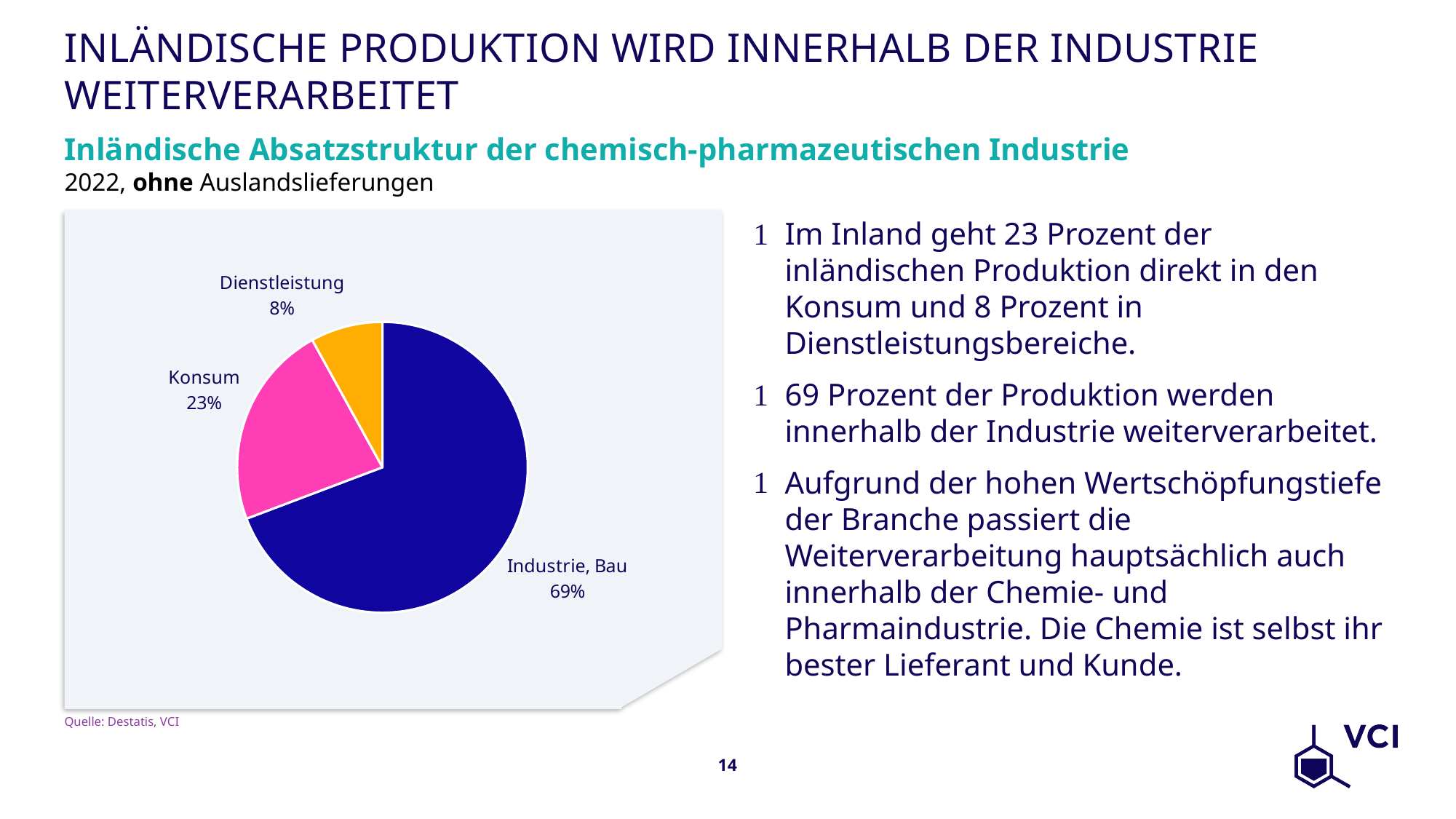
What kind of chart is shown on the slide? pie chart What share of the pie does Dienstleistung have? 8% What share of the pie does Industrie, Bau have? 69% What is the title of the chart? Inländische Absatzstruktur der chemisch-pharmazeutischen Industrie What share of the pie does Konsum have? 23% Which slice of the pie is the largest? Industrie, Bau Which slice of the pie is the smallest? Dienstleistung What is the difference in percentage points between Konsum and Dienstleistung? 15 What is the difference in percentage points between Industrie, Bau and Konsum? 46 How many slices does the pie chart have? 3 Which is larger, the share for Konsum or the share for Dienstleistung? Konsum What colour is the Konsum slice? pink